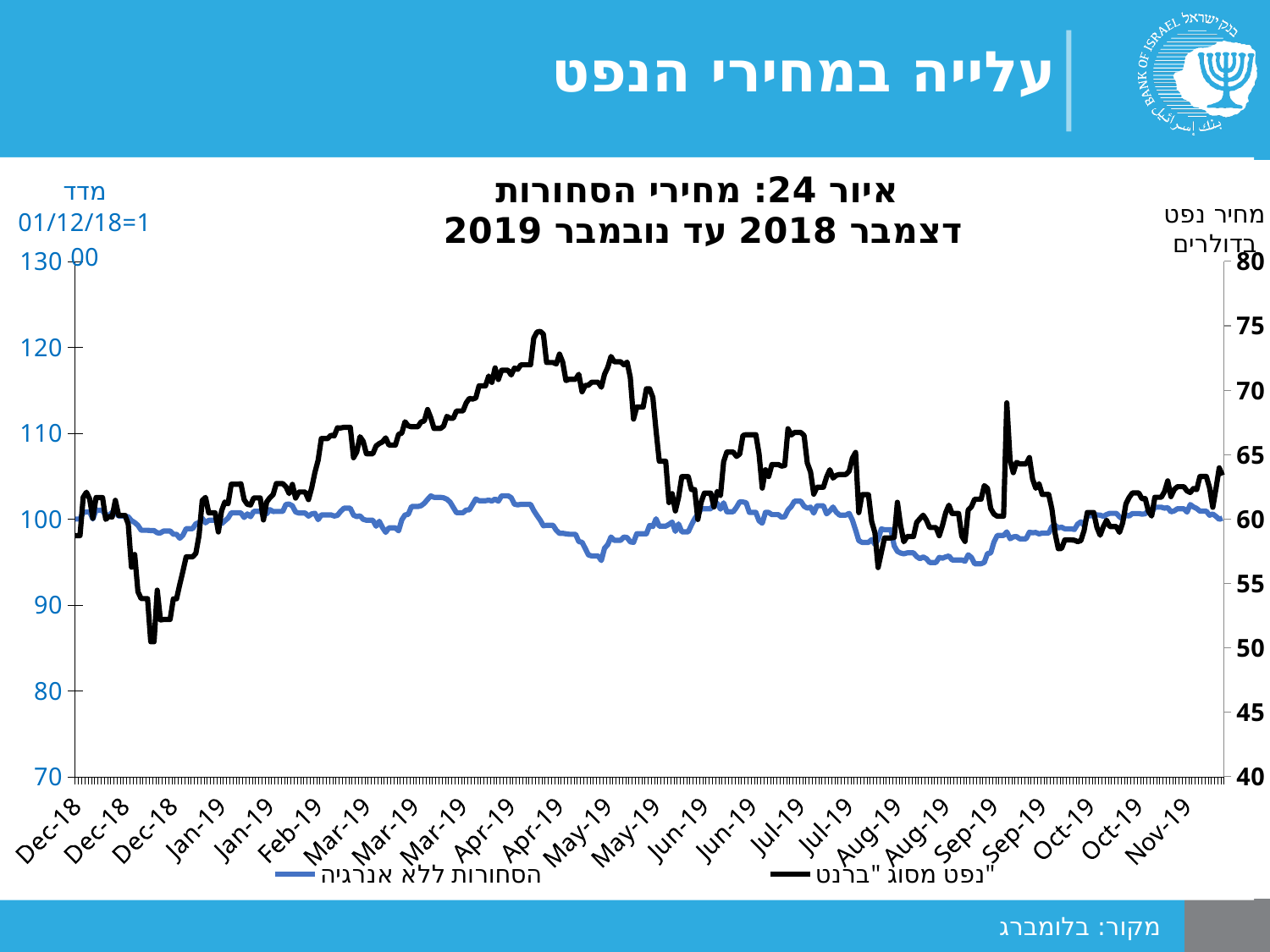
What kind of chart is shown on the slide? line chart Is the Brent oil price (right axis) at its peak in April 2019 greater or less than 70? greater Which series reaches a higher value on its own axis scale in April 2019 relative to its December 2018 level: Brent oil or non-energy commodities? נפט מסוג "ברנט" Does the Brent oil price rise or fall between late December 2018 and April 2019? rise Which series is drawn in black? נפט מסוג "ברנט" Is the Brent oil price (right axis) at its lowest point in late December 2018 greater or less than 55? less Is the Brent oil price (right axis) in November 2019 greater or less than 55? greater What is the title of the chart? איור 24: מחירי הסחורות דצמבר 2018 עד נובמבר 2019 Does the Brent oil price rise or fall between late April 2019 and August 2019? fall How many series does the legend list? 2